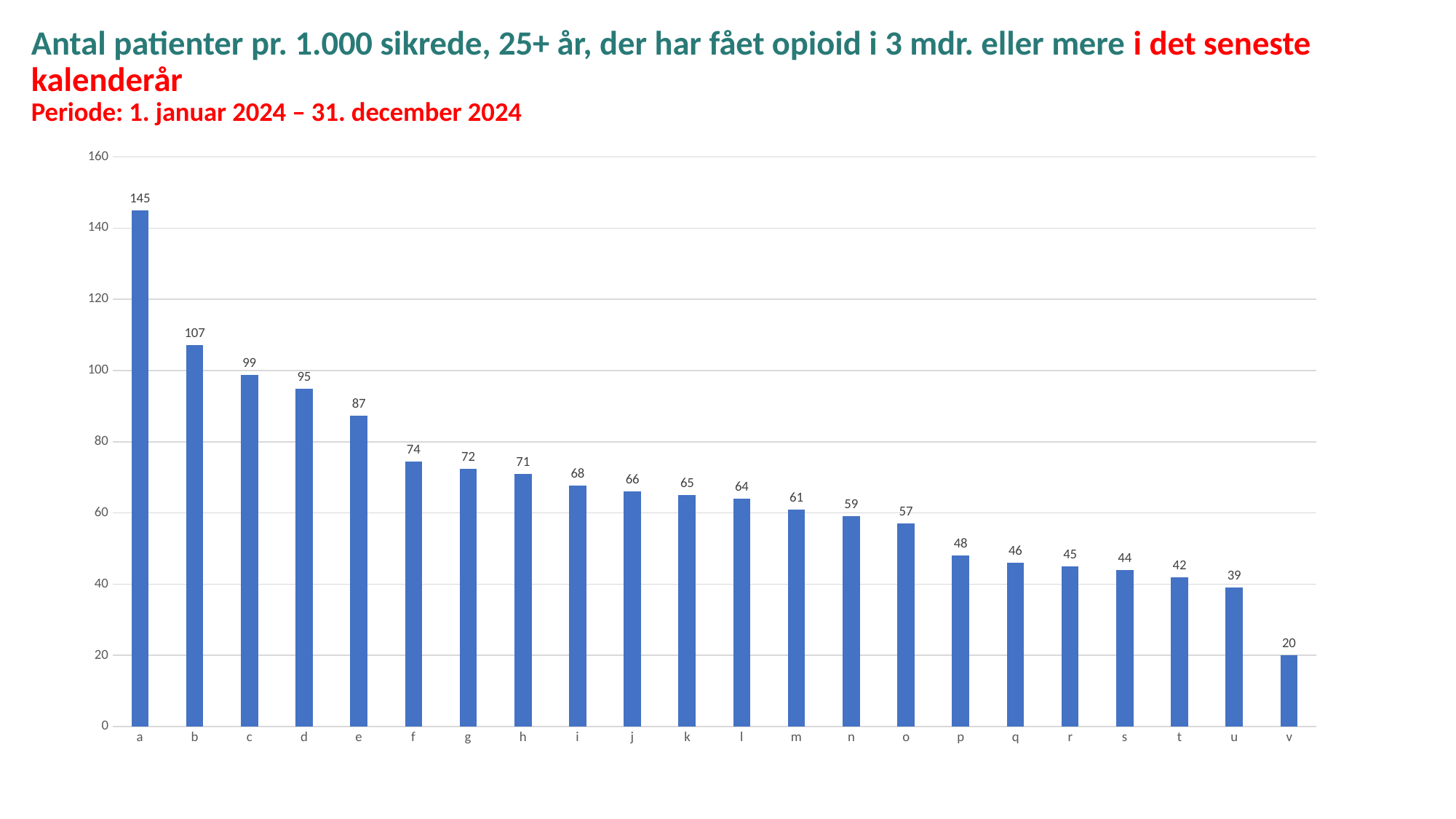
What is the difference between the values for e and v? 67 Which category has the highest value? a Which is larger, the value for c or the value for f? c What is the value for category m? 61 How many categories are shown on the x axis? 22 Which category has the lowest value? v What kind of chart is shown on the slide? bar chart Do the values rise or fall from left to right along the x axis? fall What is the value for category a? 145 What is the difference between the values for a and b? 38 Is the value for p greater or less than 60? less What is the value for category u? 39